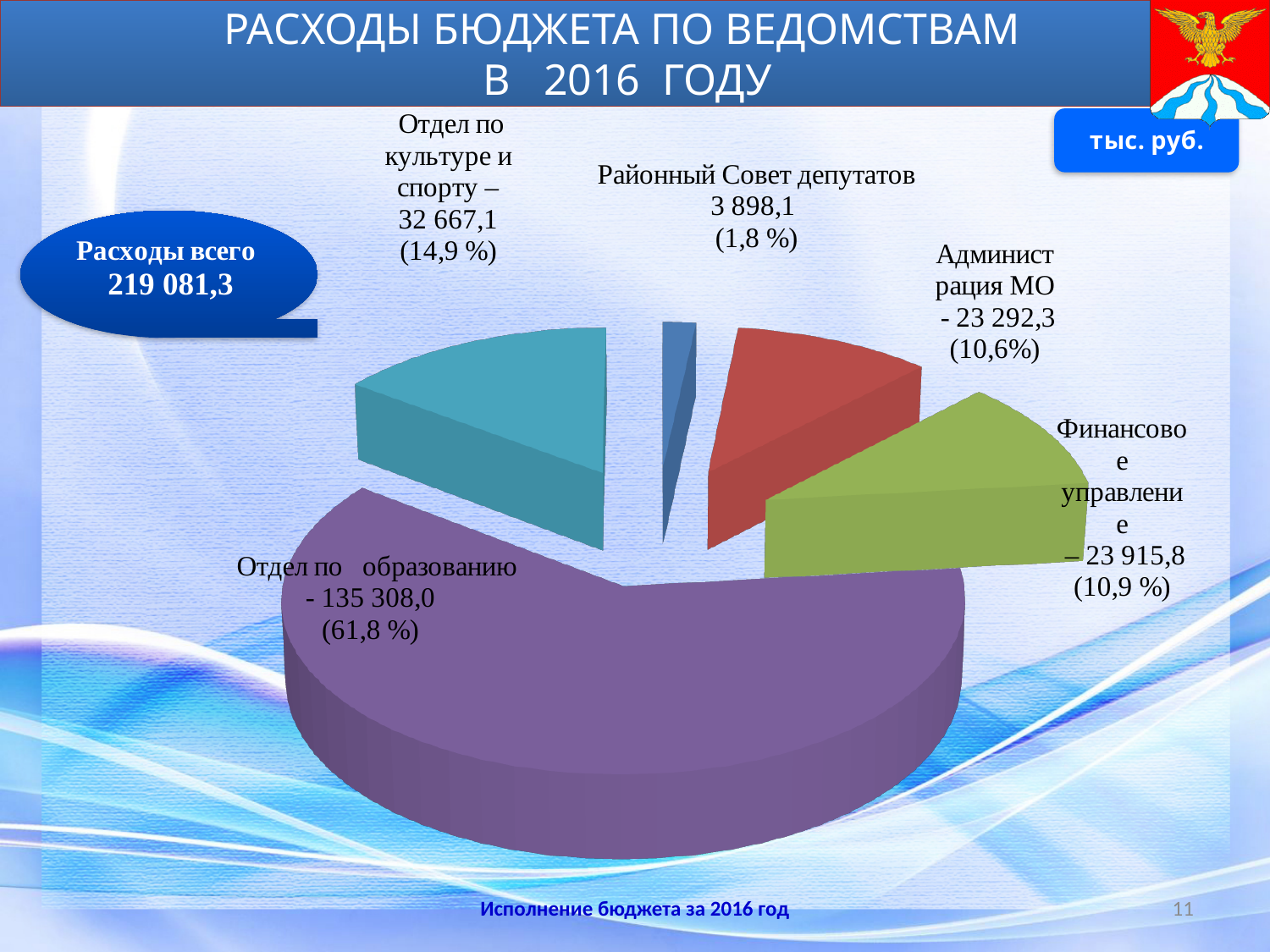
Which category has the largest slice? Отдел по образованию How many slices does the pie chart have? 5 What is the value for Районный Совет депутатов? 3 898,1 What percentage share does Отдел по культуре и спорту have? 14,9 % Which is larger, Финансовое управление or Администрация МО? Финансовое управление What is the value for Отдел по образованию? 135 308,0 What is the difference between Финансовое управление and Администрация МО? 623,5 Which category has the smallest slice? Районный Совет депутатов What is the difference between Отдел по образованию and Отдел по культуре и спорту? 102 640,9 What kind of chart is shown on the slide? Pie chart What is the value for Финансовое управление? 23 915,8 What percentage share does Администрация МО have? 10,6%